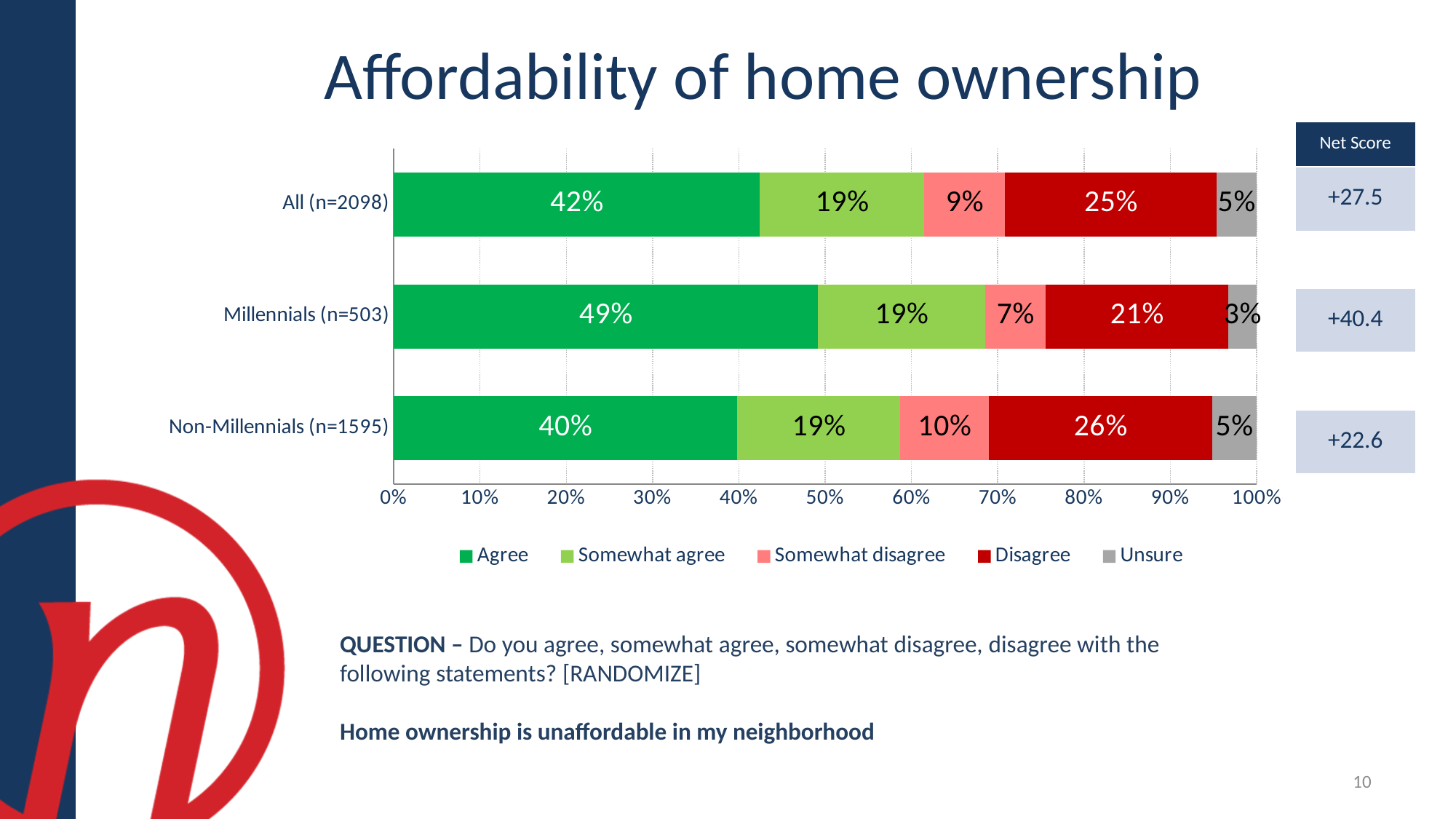
What is the Disagree value for Non-Millennials (n=1595)? 26% What kind of chart is shown on the slide? Stacked bar chart What is the Unsure value for Millennials (n=503)? 3% What is the Net Score shown for Millennials (n=503)? +40.4 Which group has the lowest Disagree percentage? Millennials (n=503) What is the difference between the Agree percentages for Millennials (n=503) and Non-Millennials (n=1595)? 9% What is the Somewhat disagree value for All (n=2098)? 9% What percentage of Millennials (n=503) agree that home ownership is unaffordable in their neighborhood? 49% How many groups (categories) are shown in the chart? 3 How many series does the legend list? 5 Which is larger: the Disagree value for All (n=2098) or the Disagree value for Non-Millennials (n=1595)? Non-Millennials (n=1595) Which group has the highest Agree percentage? Millennials (n=503)